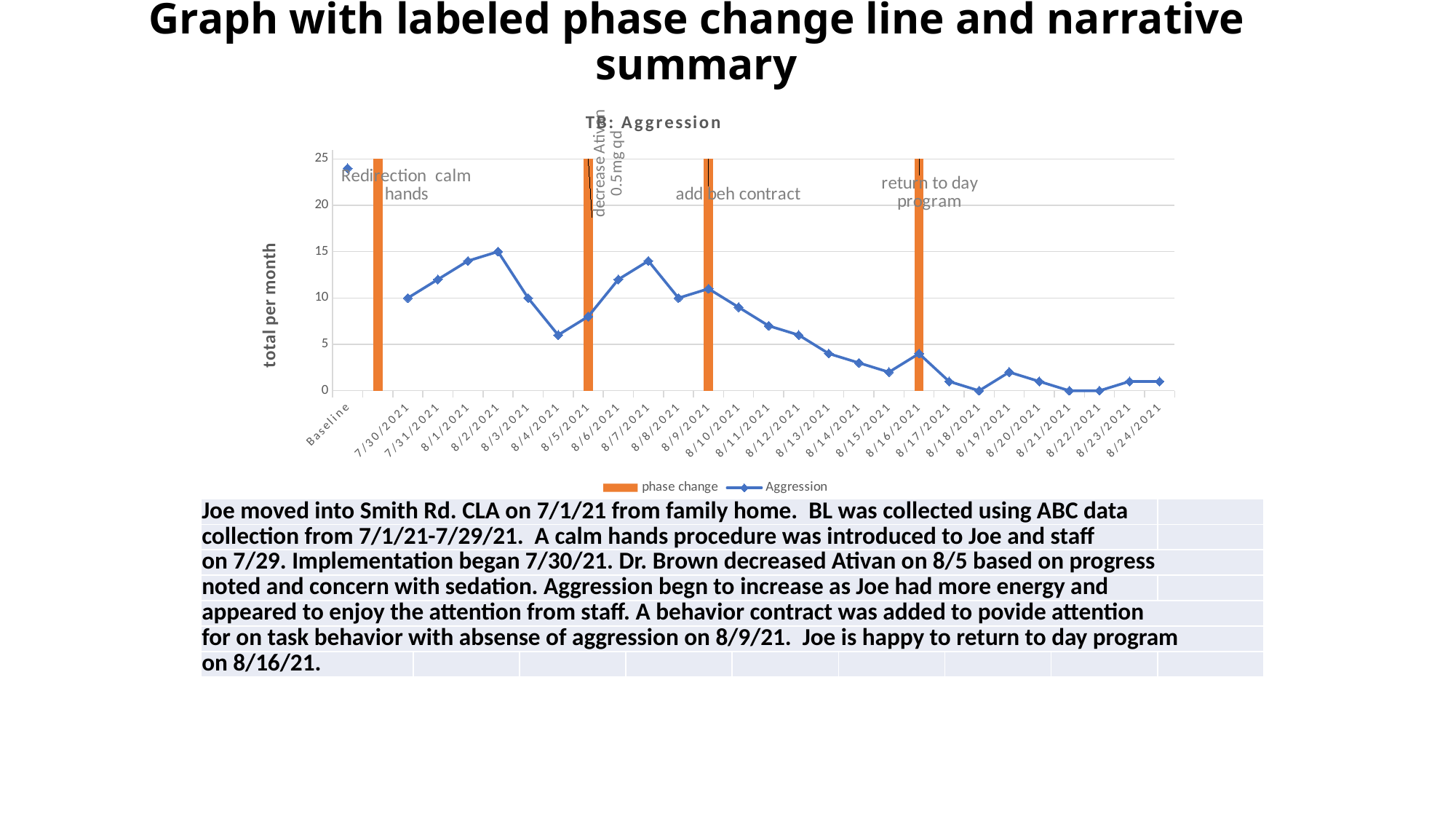
What is the Aggression value for 8/18/2021? 0 What is the label on the vertical axis of the chart? total per month How many series does the legend list? 2 What is the difference between the Aggression values for 8/2/2021 and 8/3/2021? 5 What is the title of the chart? TB: Aggression Is the Aggression value for 8/7/2021 greater or less than 10? greater Which has the larger Aggression value, 8/2/2021 or 8/16/2021? 8/2/2021 Which category has the highest Aggression value on the chart? Baseline What type of chart is shown on the slide? combination bar and line chart Is the Aggression value for 8/5/2021 greater or less than 10? less Do the Aggression values rise or fall from 8/9/2021 to 8/15/2021? fall What is the Aggression value for 8/2/2021? 15